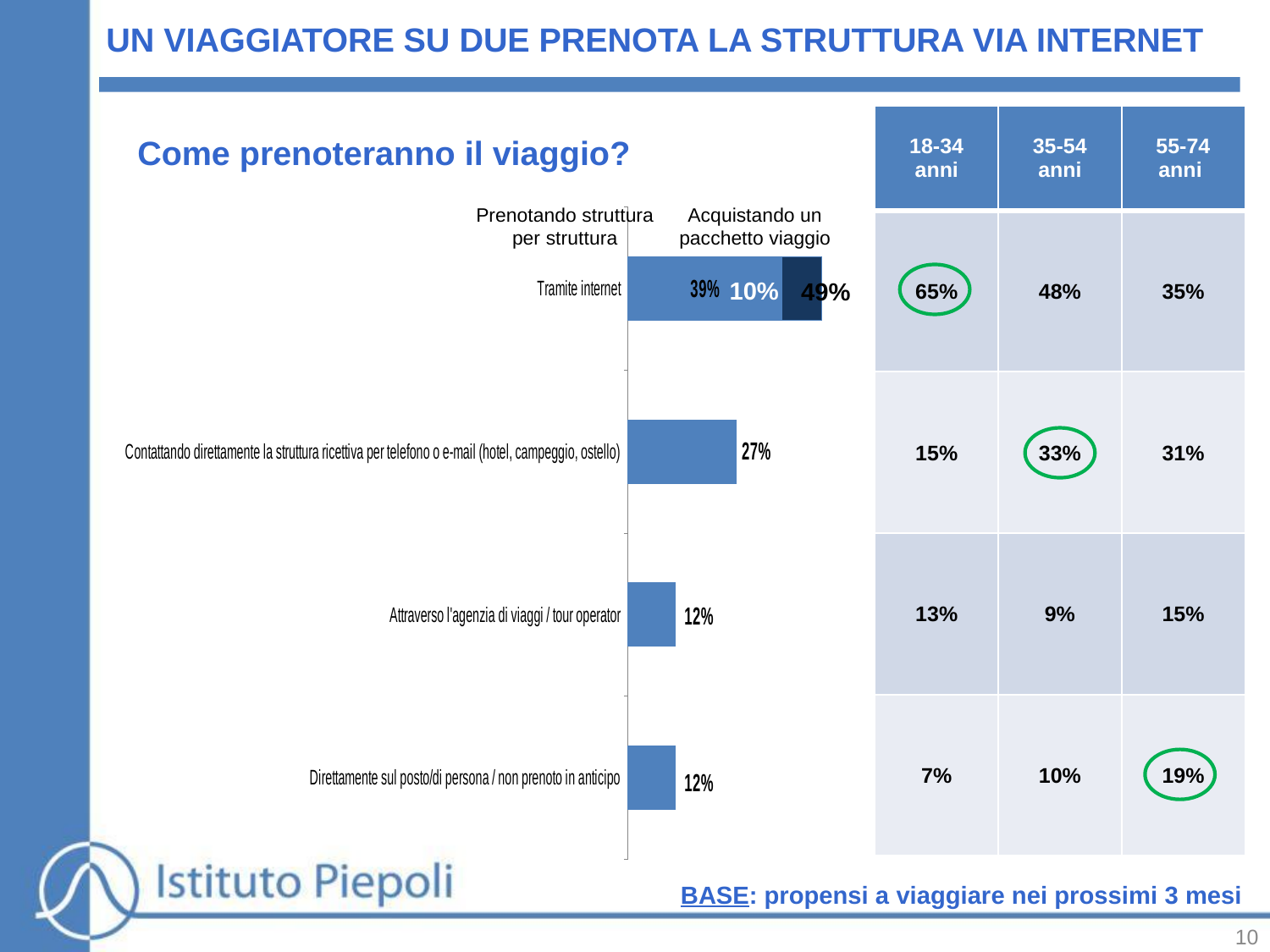
What percentage is shown for 'Contattando direttamente la struttura ricettiva per telefono o e-mail (hotel, campeggio, ostello)'? 27% What type of chart is used to show how travellers will book their trip? Bar chart Which is larger: the value for 'Contattando direttamente la struttura ricettiva' or the value for 'Direttamente sul posto/di persona / non prenoto in anticipo'? Contattando direttamente la struttura ricettiva How many booking methods (categories) are shown in the chart? 4 What is the difference in percentage points between 'Contattando direttamente la struttura ricettiva' (27%) and 'Attraverso l'agenzia di viaggi / tour operator' (12%)? 15 percentage points What is the title of the chart on the slide? Come prenoteranno il viaggio? In the 'Tramite internet' bar, what percentage corresponds to 'Prenotando struttura per struttura'? 39% In the 'Tramite internet' bar, what percentage corresponds to 'Acquistando un pacchetto viaggio'? 10% What is the difference in percentage points between the total for 'Tramite internet' (49%) and 'Contattando direttamente la struttura ricettiva' (27%)? 22 percentage points What percentage is shown for 'Attraverso l'agenzia di viaggi / tour operator'? 12% Which booking method has the highest percentage in the chart? Tramite internet What is the total percentage shown for 'Tramite internet'? 49%